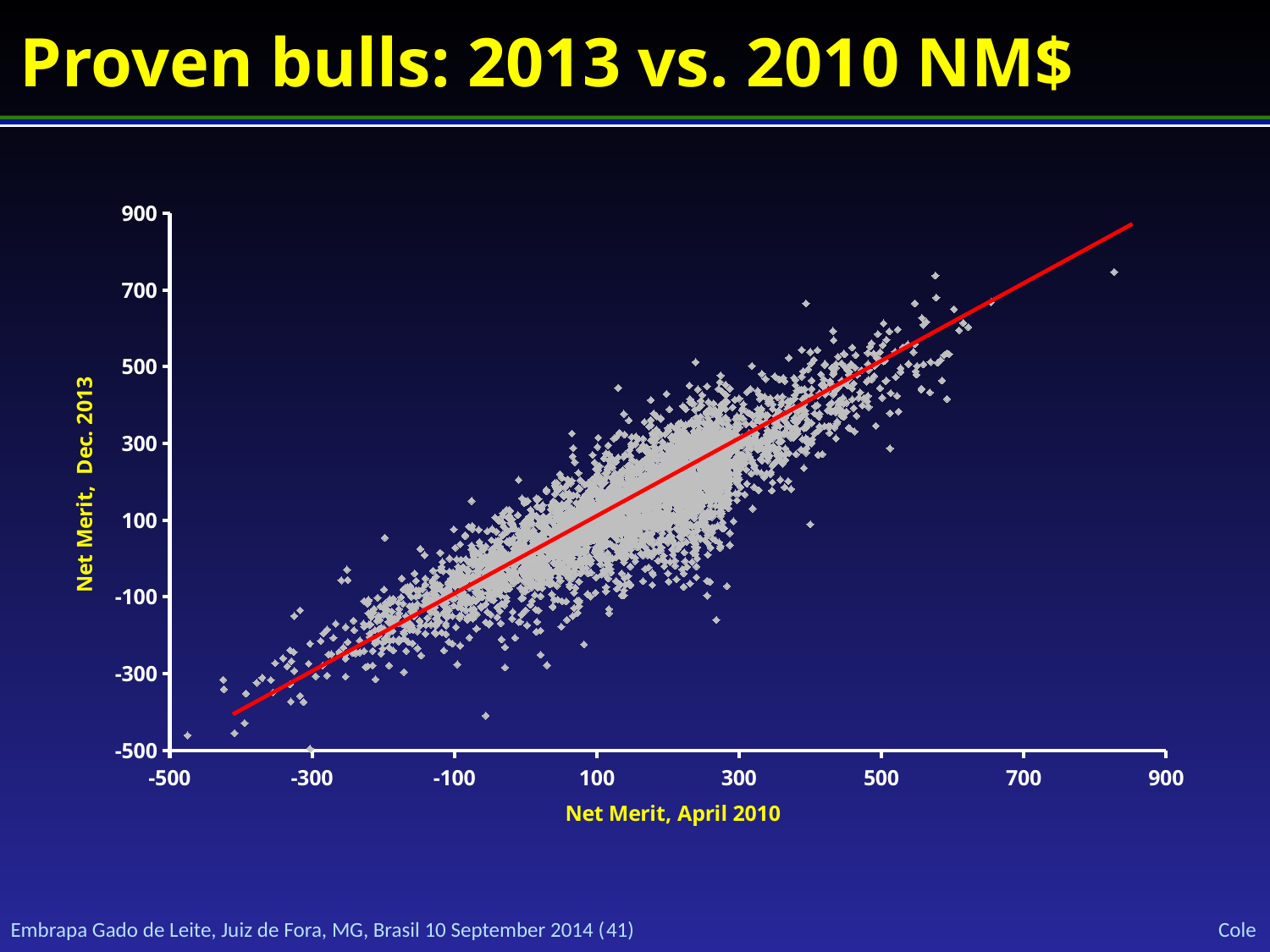
What kind of chart is shown on the slide? Scatter chart Does the red trend line slope upward or downward from left to right? Upward As Net Merit, April 2010 increases along the x axis, do the Net Merit, Dec. 2013 values generally rise or fall? Rise What is the highest tick value shown on the y axis? 900 What is the title of the chart? Proven bulls: 2013 vs. 2010 NM$ What is the lowest tick value shown on the x axis? -500 What is the label of the x axis? Net Merit, April 2010